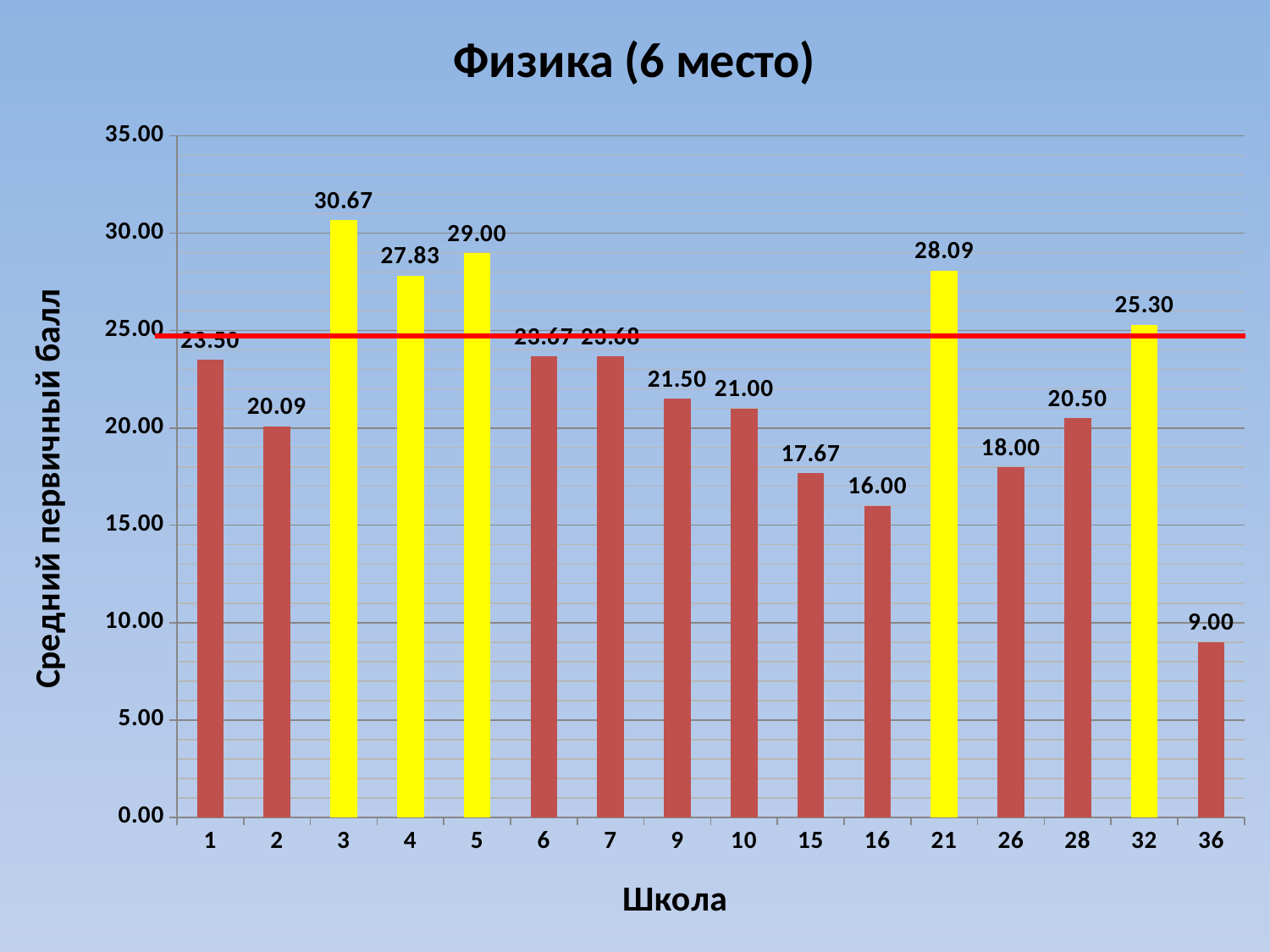
How many schools are shown on the x axis? 16 What is the title of the chart? Физика (6 место) What is the label of the x axis? Школа What is the average score for school 32? 25.30 Which school has the highest average score? 3 What is the difference between the scores of school 3 and school 5? 1.67 What is the difference between the scores of school 26 and school 16? 2.00 Which school has the lowest average score? 36 Which has a higher score, school 4 or school 21? school 21 What is the average score for school 21? 28.09 What kind of chart is shown on the slide? bar chart What is the average score for school 16? 16.00